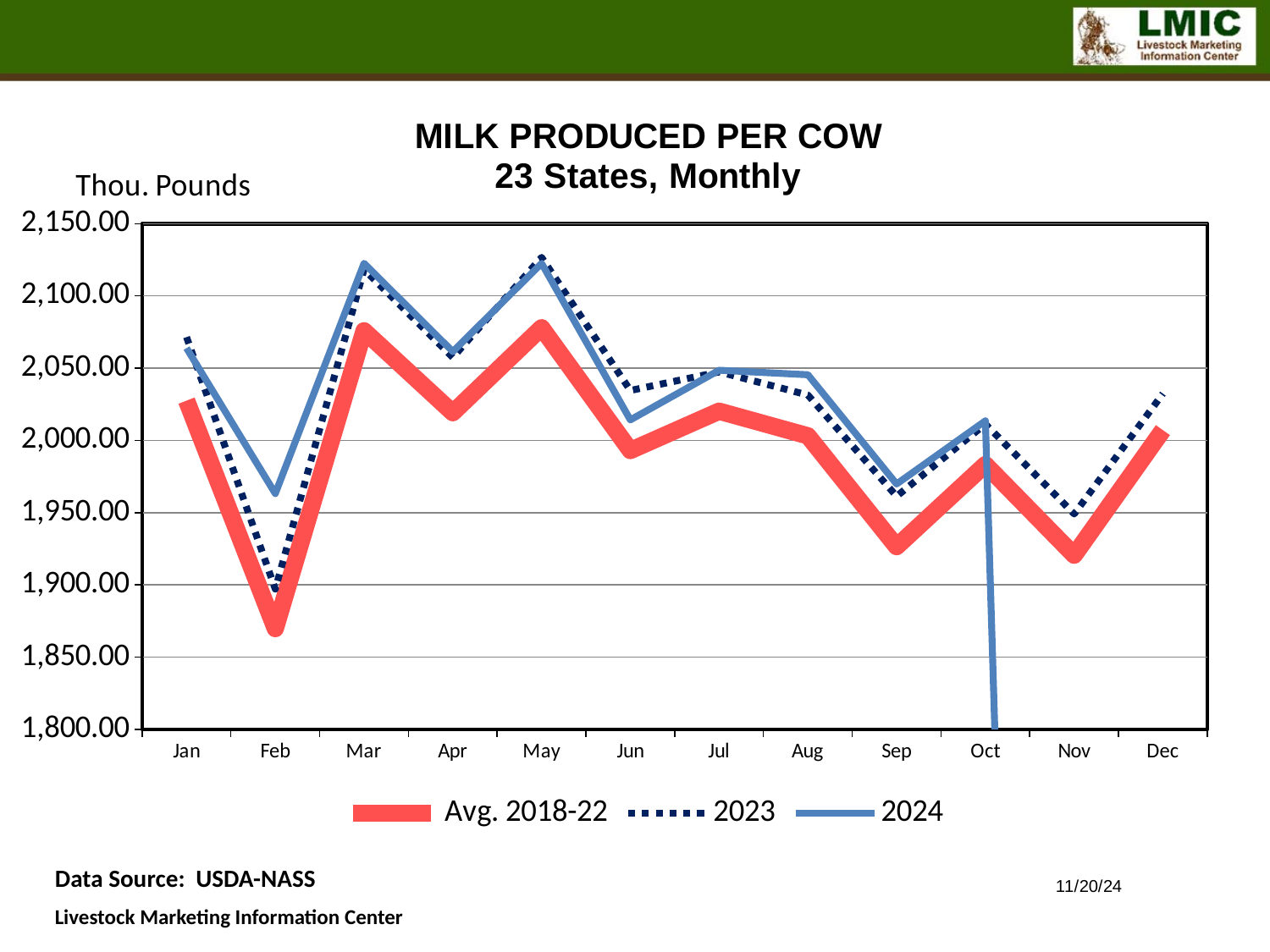
What unit is shown on the y axis label? Thou. Pounds How many months are shown along the x axis? 12 Is the 2023 value for Dec greater or less than 2,000.00? greater Is the 2024 value for Mar greater or less than 2,100.00? greater In Feb, which is larger: the 2024 value or the Avg. 2018-22 value? 2024 In which month is the 2023 series at its lowest? Feb In which month is the Avg. 2018-22 series at its lowest? Feb What kind of chart is shown on the slide? Line chart How many series does the legend list? 3 Does the Avg. 2018-22 series rise or fall from Jan to Feb? Fall Is the Avg. 2018-22 value for Nov greater or less than 1,950.00? less